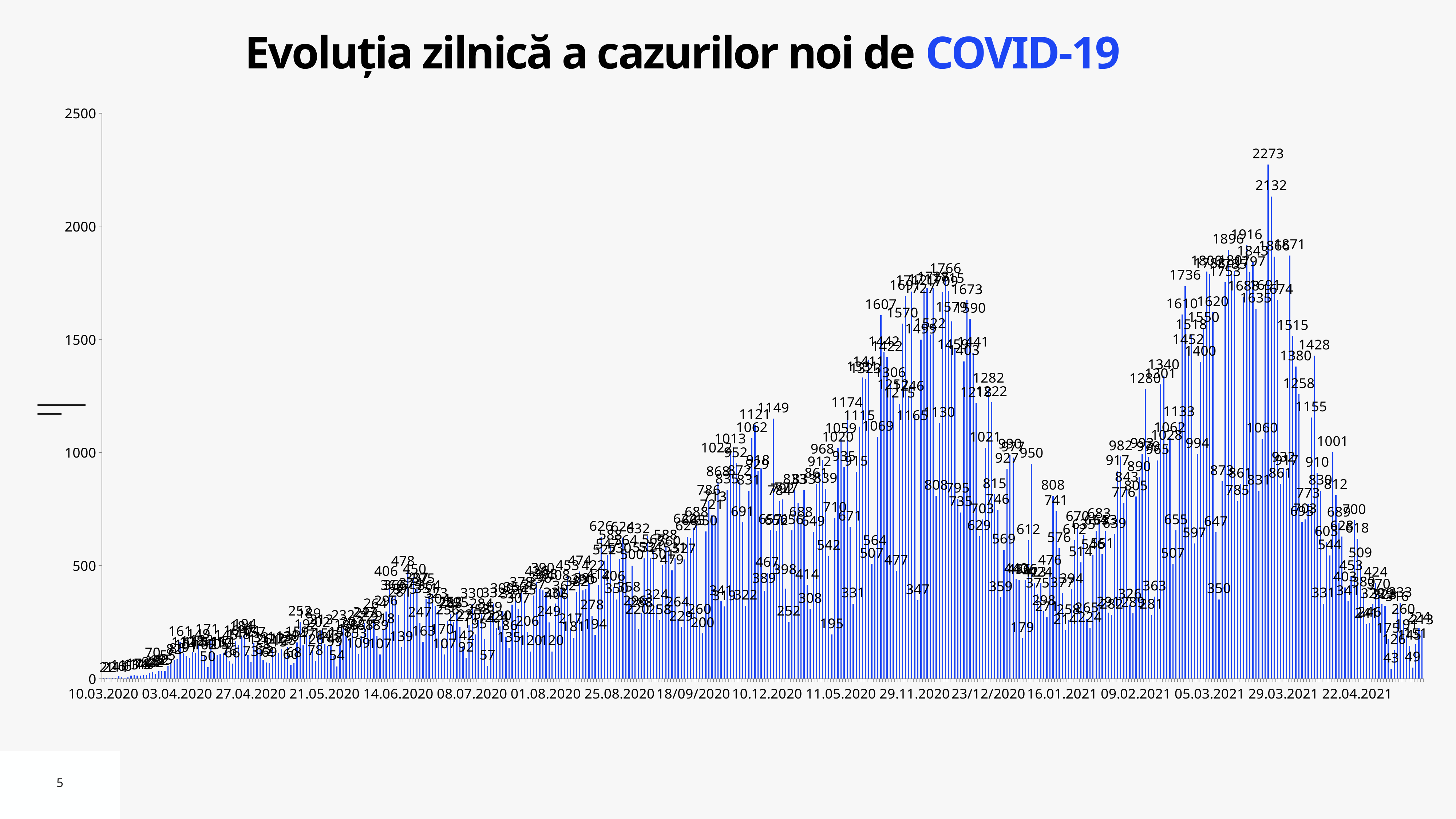
Is the value at the first date, 10.03.2020, greater or less than 500? less Is the highest bar on the chart greater or less than 2000? greater Do the values rise or fall between 29.03.2021 and 22.04.2021? fall What is the difference between the two highest labelled values, 2273 and 2132? 141 How many data series are plotted on the chart? 1 What kind of chart is shown on the slide? bar chart What is the title of the chart? Evoluția zilnică a cazurilor noi de COVID-19 Do the values rise or fall between 10.03.2020 and 03.04.2020? rise What is the second-highest daily value labelled on the chart? 2132 What is the maximum value shown on the vertical axis? 2500 What is the highest daily value labelled on the chart? 2273